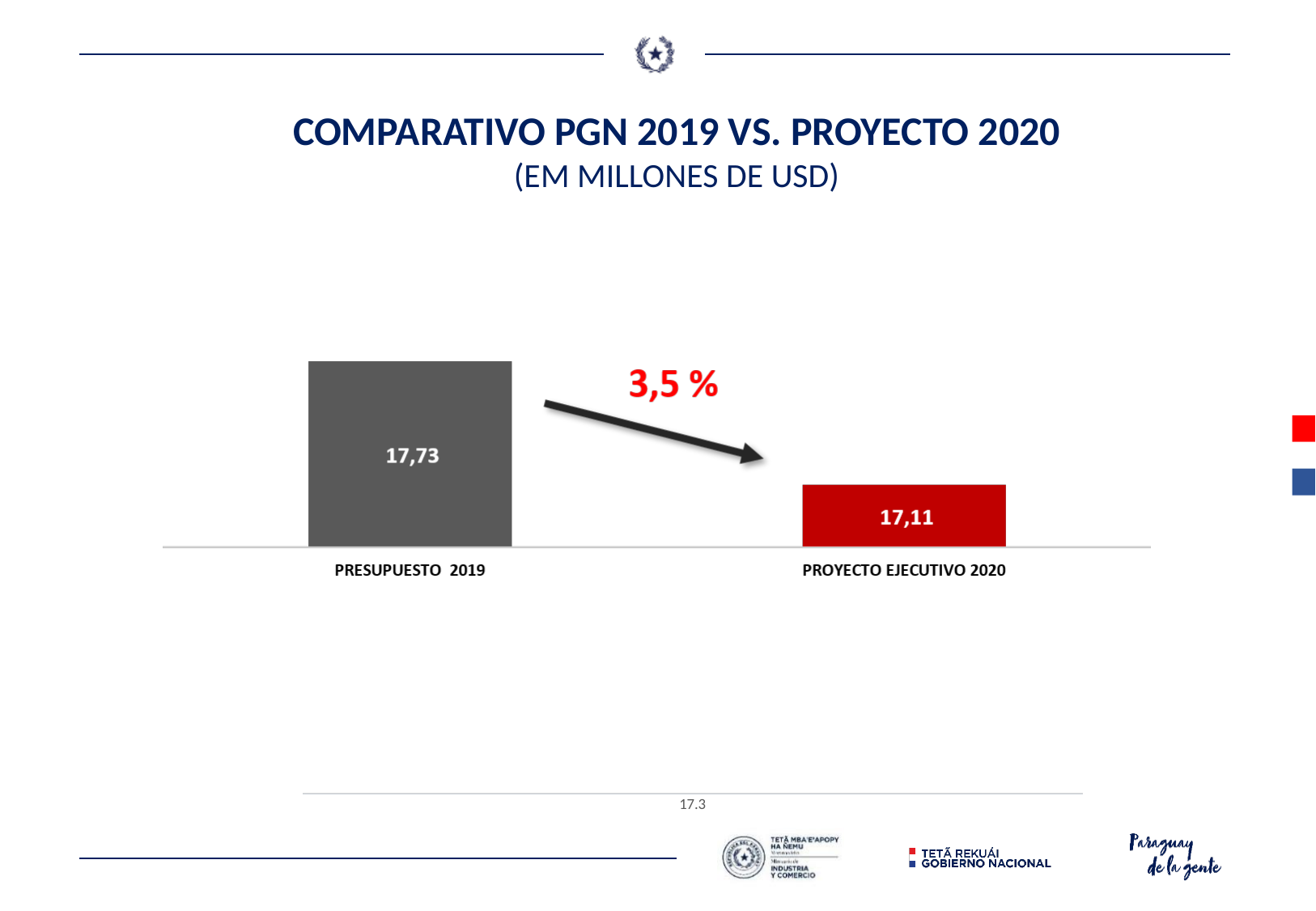
What is the value for PROYECTO EJECUTIVO 2020? 17,11 What percentage change is annotated next to the arrow between the two bars? 3,5 % Do the values rise or fall from PRESUPUESTO 2019 to PROYECTO EJECUTIVO 2020? Fall What is the title of the chart? COMPARATIVO PGN 2019 VS. PROYECTO 2020 (EM MILLONES DE USD) Which category has the highest value? PRESUPUESTO 2019 Which is larger, the value for PRESUPUESTO 2019 or the value for PROYECTO EJECUTIVO 2020? PRESUPUESTO 2019 How many categories are shown in the chart? 2 Which category has the lowest value? PROYECTO EJECUTIVO 2020 What is the value for PRESUPUESTO 2019? 17,73 What is the difference between the values for PRESUPUESTO 2019 and PROYECTO EJECUTIVO 2020? 0,62 What kind of chart is shown on the slide? Bar chart